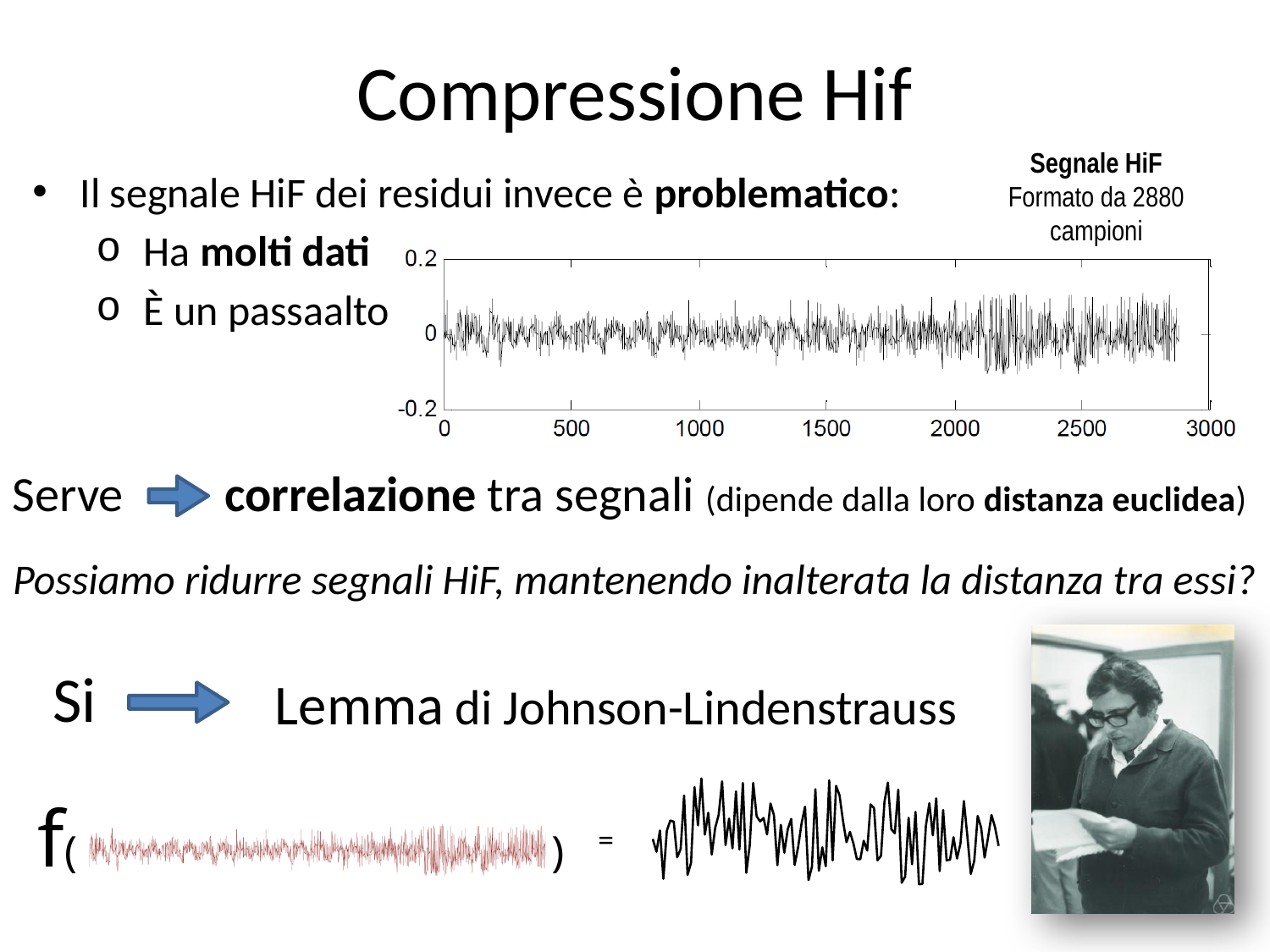
Does the amplitude of the signal's oscillations increase or decrease toward the right end of the x axis? increase What is the largest tick value shown on the x axis of the chart? 3000 What is the highest value shown on the y axis of the chart? 0.2 How many samples (campioni) make up the HiF signal shown in the chart? 2880 Around which value does the plotted signal oscillate? 0 Is the signal's oscillation amplitude larger in the first half (0–1500) or in the second half (1500–3000) of the x axis? second half Is the minimum value of the plotted signal greater or less than -0.2? greater What kind of chart is shown on the slide? line chart Is the maximum value of the plotted signal greater or less than 0.2? less What is the title of the chart on the slide? Segnale HiF